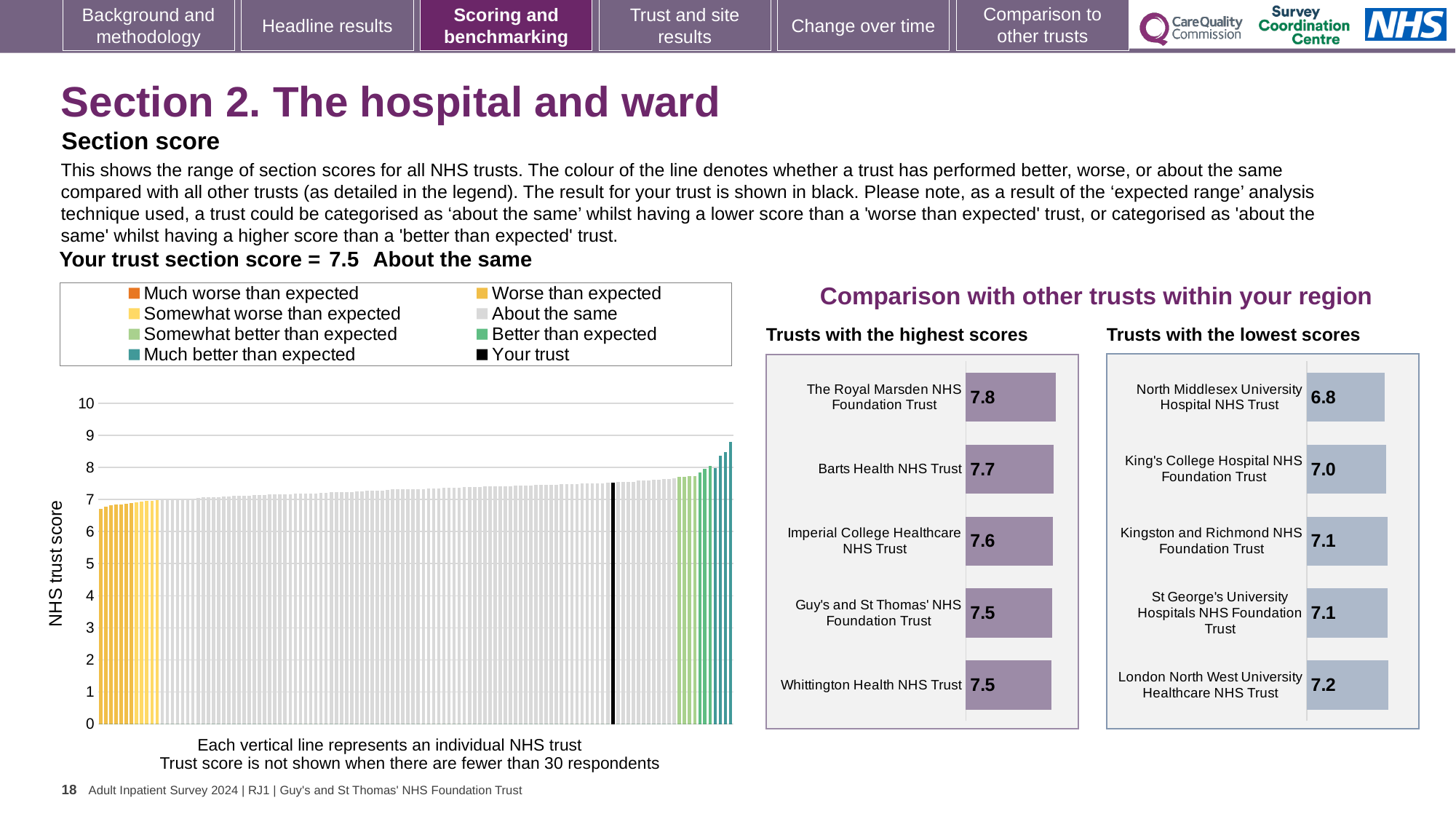
In the 'Trusts with the highest scores' chart, which trust has the highest score? The Royal Marsden NHS Foundation Trust In the 'Trusts with the lowest scores' chart, what is the score for North Middlesex University Hospital NHS Trust? 6.8 How many entries does the legend of the main NHS trust score chart on the left list? 8 How many trusts are shown in the 'Trusts with the highest scores' chart? 5 In the 'Trusts with the highest scores' chart, which has the higher score: Barts Health NHS Trust or Imperial College Healthcare NHS Trust? Barts Health NHS Trust In the 'Trusts with the lowest scores' chart, what is the score for London North West University Healthcare NHS Trust? 7.2 In the 'Trusts with the highest scores' chart, what is the difference between the scores of The Royal Marsden NHS Foundation Trust and Whittington Health NHS Trust? 0.3 What kind of chart is the main NHS trust score chart on the left? bar chart In the 'Trusts with the highest scores' chart, what is the score for The Royal Marsden NHS Foundation Trust? 7.8 In the 'Trusts with the lowest scores' chart, what is the difference between the scores of London North West University Healthcare NHS Trust and North Middlesex University Hospital NHS Trust? 0.4 In the 'Trusts with the lowest scores' chart, which trust has the lowest score? North Middlesex University Hospital NHS Trust In the main NHS trust score chart on the left, is the value for the black 'Your trust' bar greater or less than 7? greater